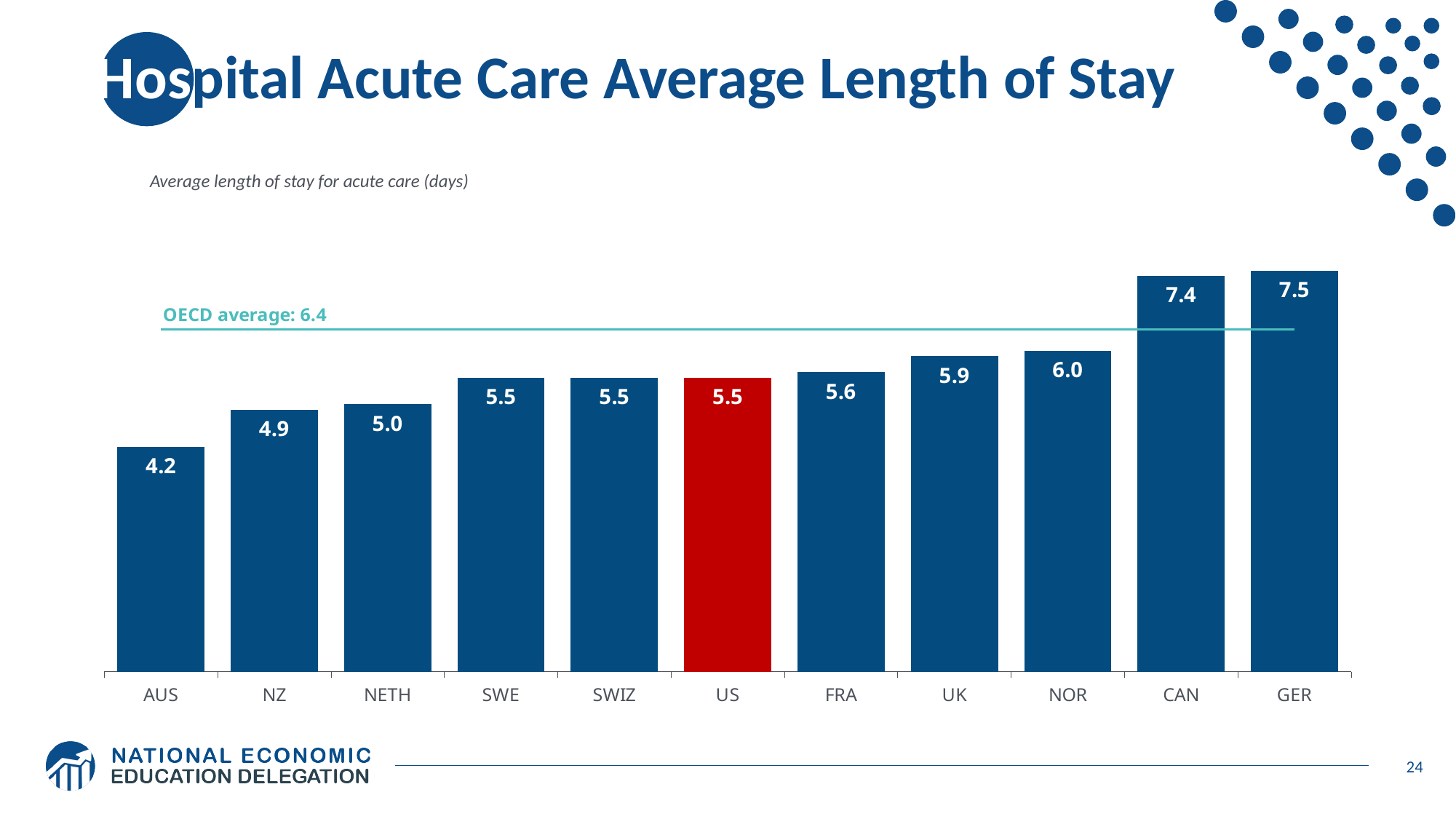
What is the difference in average length of stay between CAN and AUS? 3.2 What is the OECD average shown on the chart? 6.4 What is the average length of stay for acute care in Australia (AUS)? 4.2 Which country's bar is highlighted in red? US How many countries are shown in the chart? 11 Which country has the highest average length of stay for acute care? GER What is the average length of stay for acute care in Germany (GER)? 7.5 What type of chart is shown on the slide? Bar chart What is the average length of stay for acute care in the US? 5.5 Which has a longer average length of stay, NOR or NETH? NOR Which country has the lowest average length of stay for acute care? AUS Do the values rise or fall from left to right across the x axis? Rise